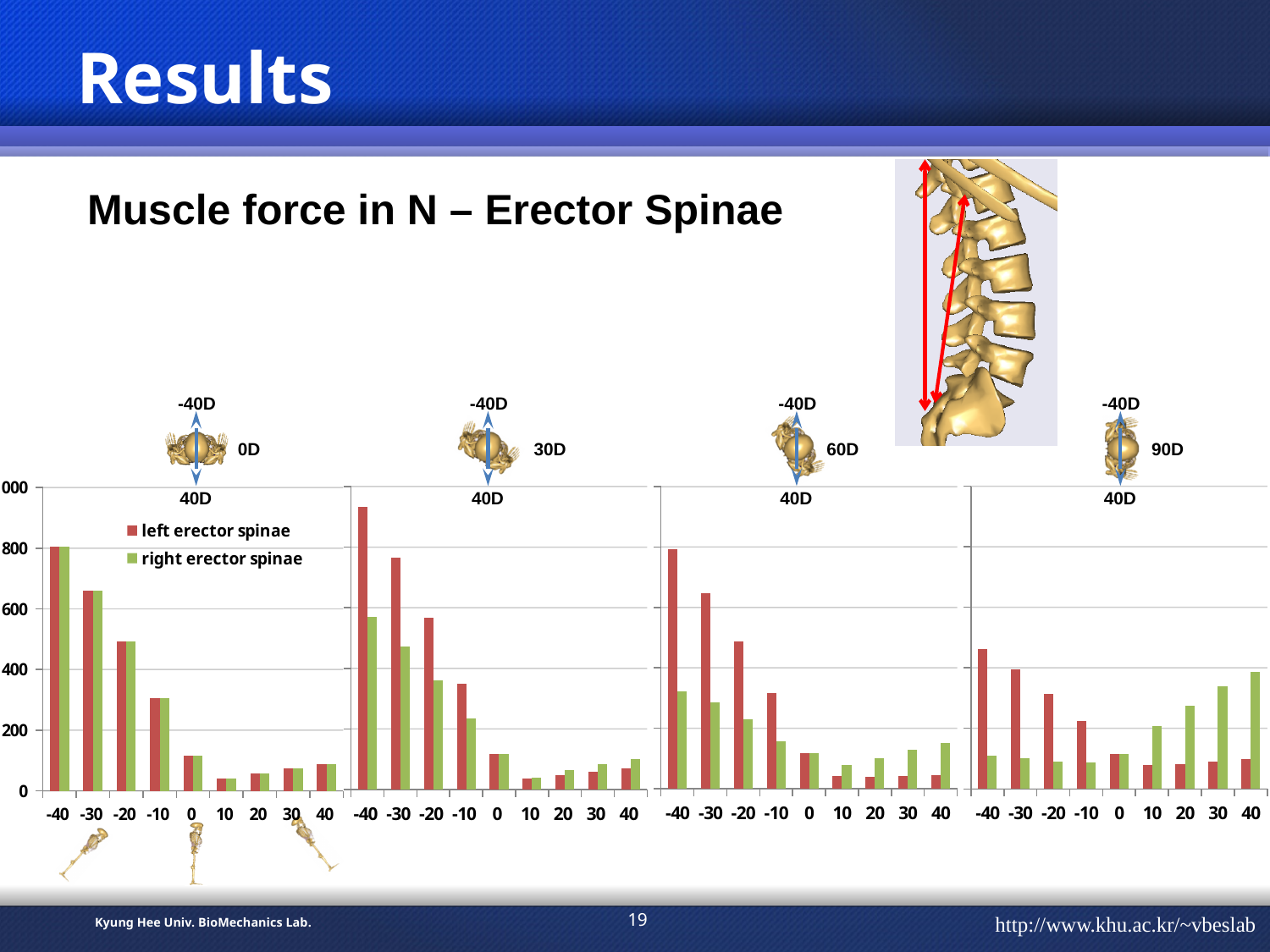
Which colour represents right erector spinae in the legend? green How many categories are shown on the x axis of the 30D chart? 9 In the 30D chart, at which x-axis category is the left erector spinae value highest? -40 In the 90D chart, which is larger at 40: left erector spinae or right erector spinae? right erector spinae In the 60D chart, do the left erector spinae values rise or fall from -40 to 0? fall In the 60D chart, which is larger at -30: left erector spinae or right erector spinae? left erector spinae In the 60D chart, is the value for right erector spinae at -40 greater or less than 400? less In the 0D chart, is the value for left erector spinae at 0 greater or less than 200? less How many series does the legend on the 0D chart list? 2 In the 90D chart, is the value for left erector spinae at -40 greater or less than 400? greater What kind of chart is the 0D chart? bar chart